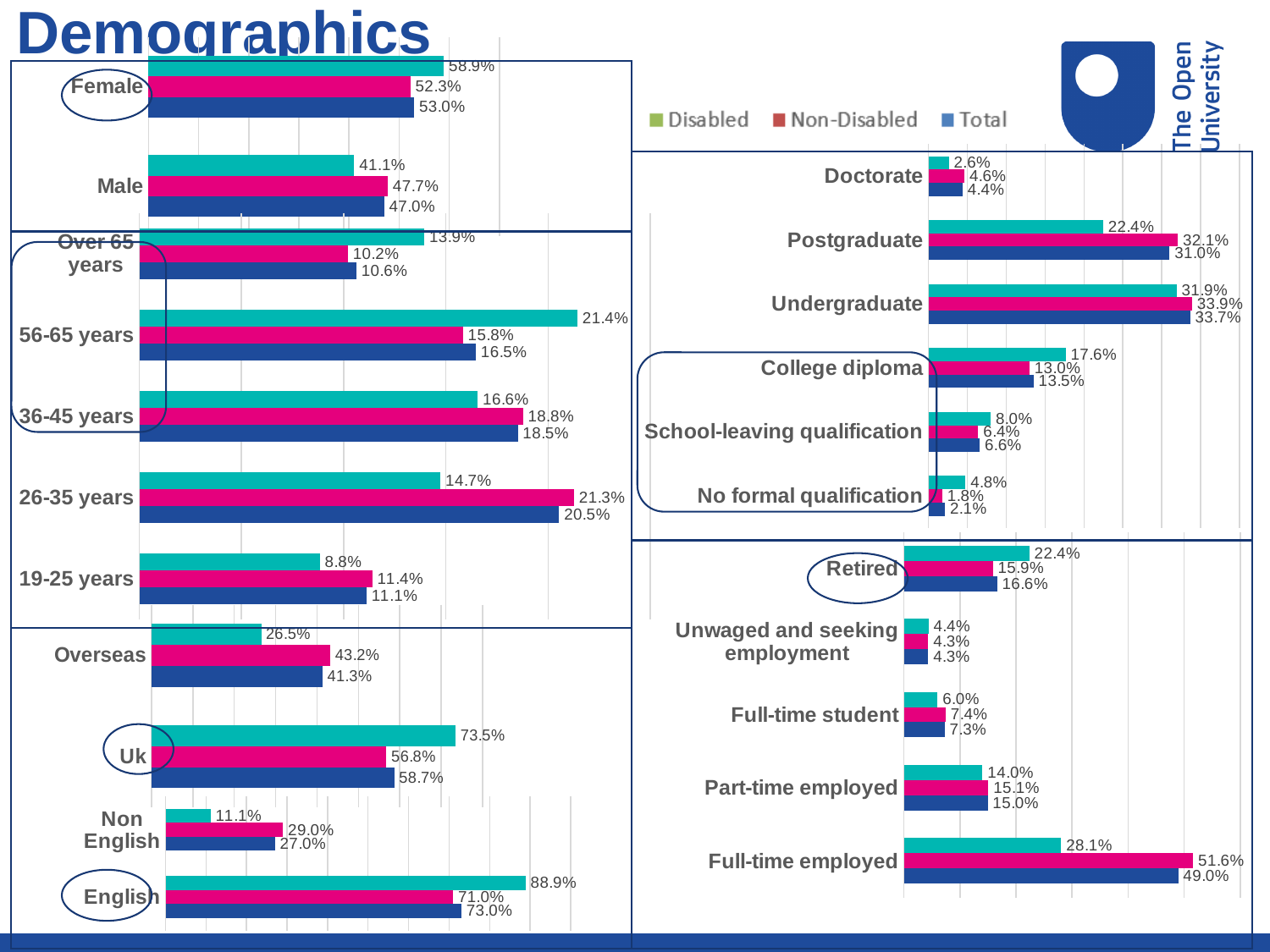
In the employment chart at the bottom right, what is the difference between the Non-Disabled and Disabled values for Full-time employed? 23.5% In the qualification chart on the right, what is the Total value for Postgraduate? 31.0% In the age chart on the left, which age group has the lowest Total value? Over 65 years In the gender chart at the top left, what is the Disabled value for Female? 58.9% In the age chart on the left, which age group has the highest Disabled value? 56-65 years What kind of chart is used for the employment data at the bottom right? bar chart In the qualification chart on the right, which qualification has the lowest Disabled value? Doctorate In the location and language chart at the bottom left, is the Disabled value for Uk larger or smaller than the Non-Disabled value for Uk? larger In the location and language chart at the bottom left, what is the difference between the Disabled and Non-Disabled values for English? 17.9% How many series does the legend list? 3 In the age chart on the left, what is the Non-Disabled value for 26-35 years? 21.3% In the gender chart at the top left, what is the Total value for Male? 47.0%